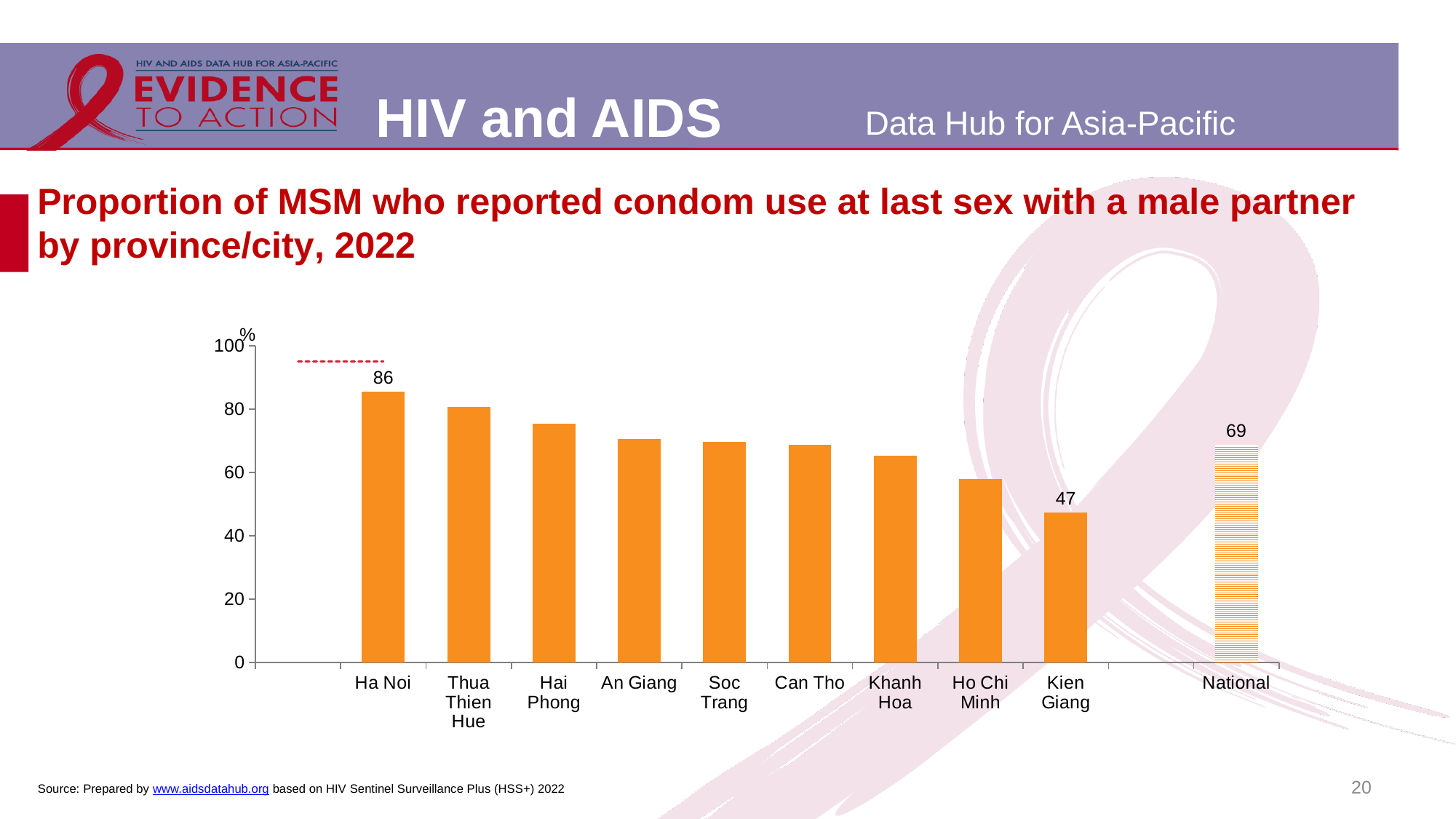
How many bars are shown in the chart, including National? 10 Is the value for Ho Chi Minh greater or less than 60? less Which province/city has the highest proportion? Ha Noi Which province/city has the lowest proportion? Kien Giang What is the value for Kien Giang? 47 What kind of chart is shown on the slide? Bar chart What is the difference between the National value and the value for Kien Giang? 22 Which is larger, the value for Ha Noi or the National value? Ha Noi What is the difference between the values for Ha Noi and Kien Giang? 39 What is the value for Ha Noi? 86 What is the National value shown in the chart? 69 Is the value for Hai Phong greater or less than 80? less